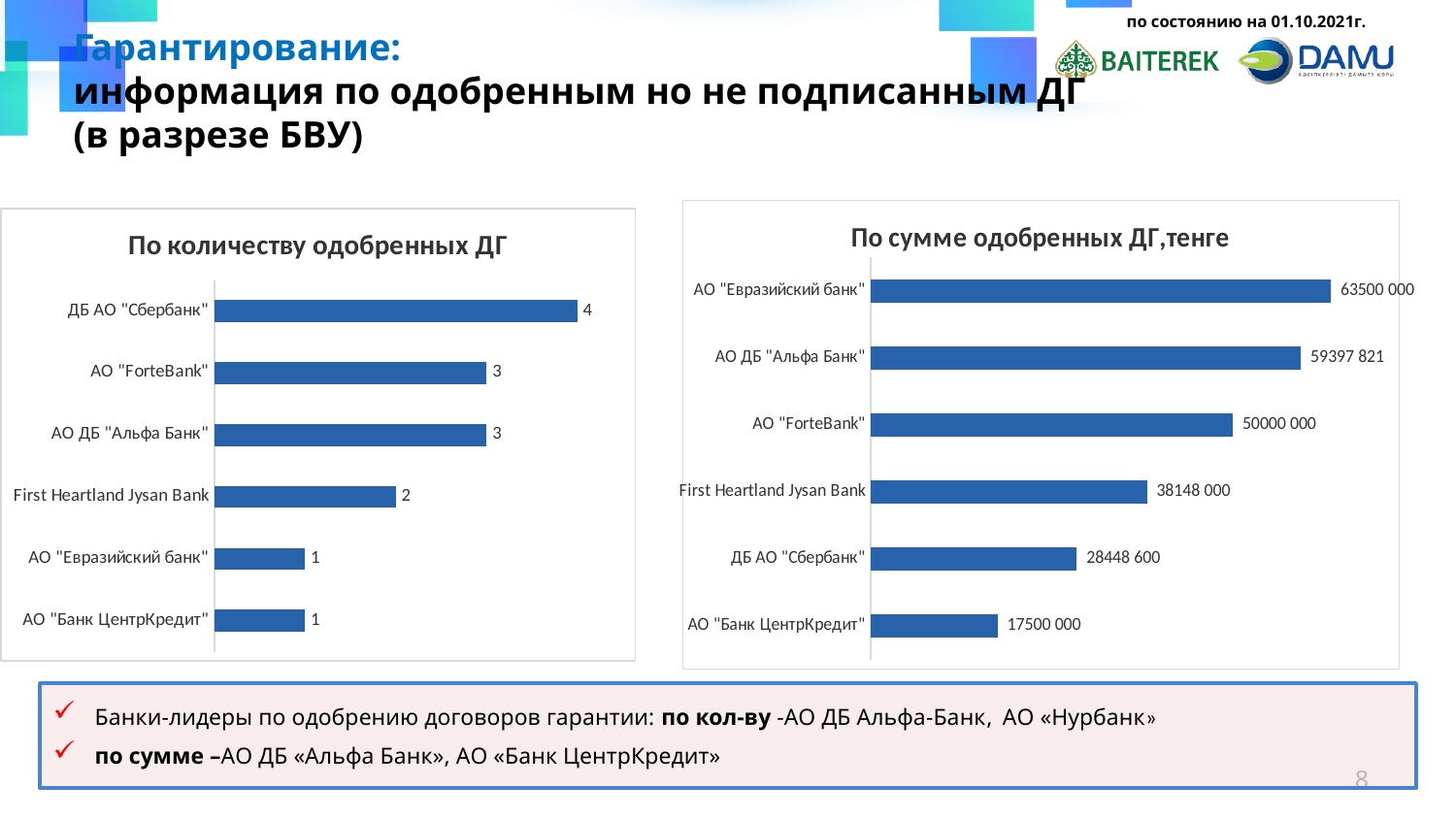
In the chart "По сумме одобренных ДГ,тенге", what is the value for ДБ АО "Сбербанк"? 28448 600 In the chart "По количеству одобренных ДГ", how many banks are shown? 6 In the chart "По сумме одобренных ДГ,тенге", what is the value for АО "Евразийский банк"? 63500 000 In the chart "По сумме одобренных ДГ,тенге", which bank has the lowest value? АО "Банк ЦентрКредит" In the chart "По количеству одобренных ДГ", what is the difference between ДБ АО "Сбербанк" and АО "ForteBank"? 1 In the chart "По количеству одобренных ДГ", what is the value for First Heartland Jysan Bank? 2 In the chart "По количеству одобренных ДГ", what is the value for ДБ АО "Сбербанк"? 4 In the chart "По сумме одобренных ДГ,тенге", what is the difference between АО "ForteBank" and АО "Банк ЦентрКредит"? 32500 000 What type of chart is the chart "По сумме одобренных ДГ,тенге"? Bar chart In the chart "По сумме одобренных ДГ,тенге", what is the value for АО ДБ "Альфа Банк"? 59397 821 In the chart "По сумме одобренных ДГ,тенге", which is larger: АО "ForteBank" or First Heartland Jysan Bank? АО "ForteBank" In the chart "По количеству одобренных ДГ", which bank has the highest value? ДБ АО "Сбербанк"